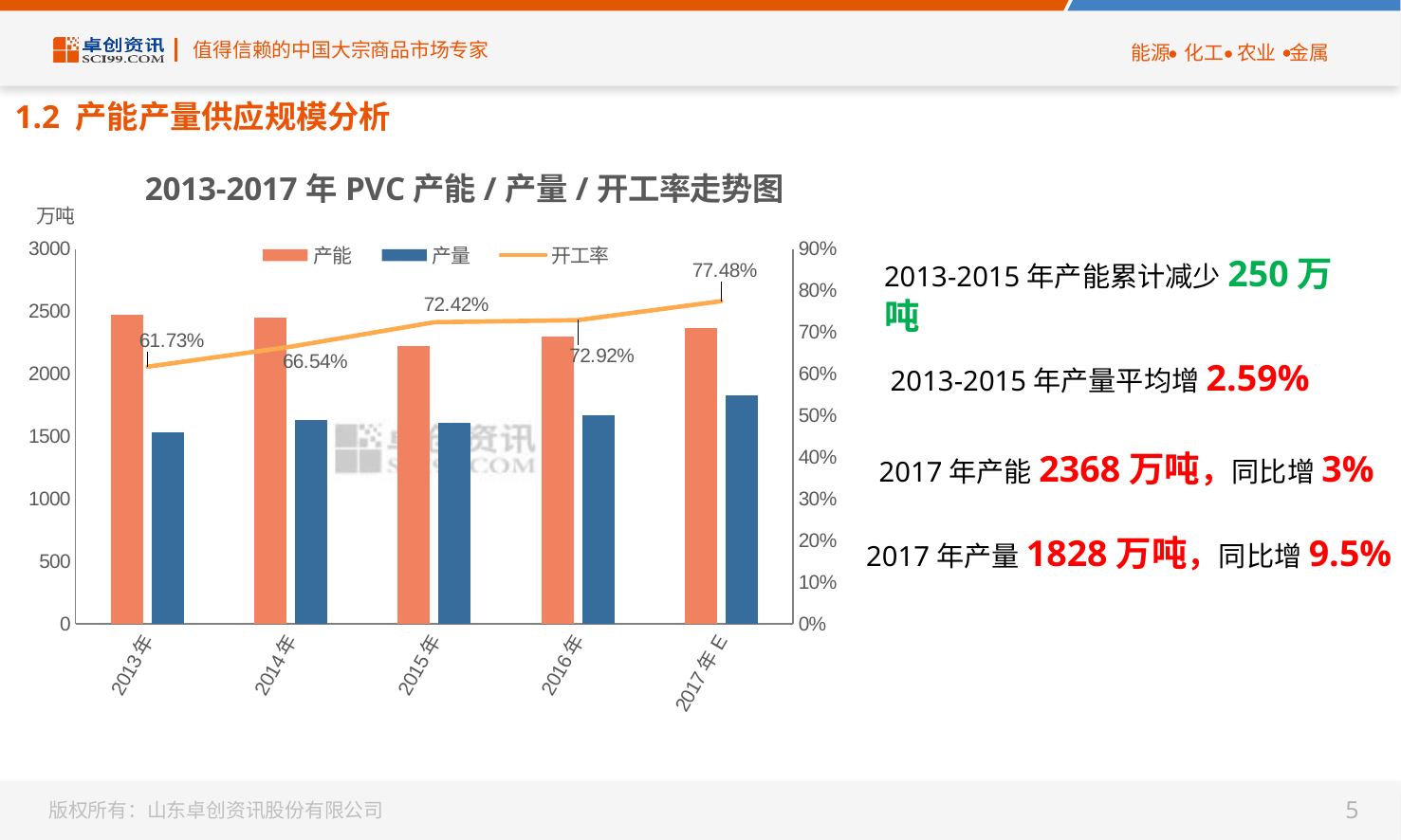
Is the 产能 value for 2013年 greater or less than 2000? greater Does the 开工率 line rise or fall from 2013年 to 2017年E? rises What is the difference between the 开工率 for 2017年E and 2013年? 15.75% Is the 产量 value for 2013年 greater or less than 2000? less What is the 开工率 value for 2013年? 61.73% How many years are shown on the x axis? 5 What is the 开工率 value for 2017年E? 77.48% Which year has a higher 开工率, 2014年 or 2015年? 2015年 What is the 开工率 value for 2015年? 72.42% Which year has the highest 开工率? 2017年E Which year has the lowest 开工率? 2013年 How many series does the legend list? 3